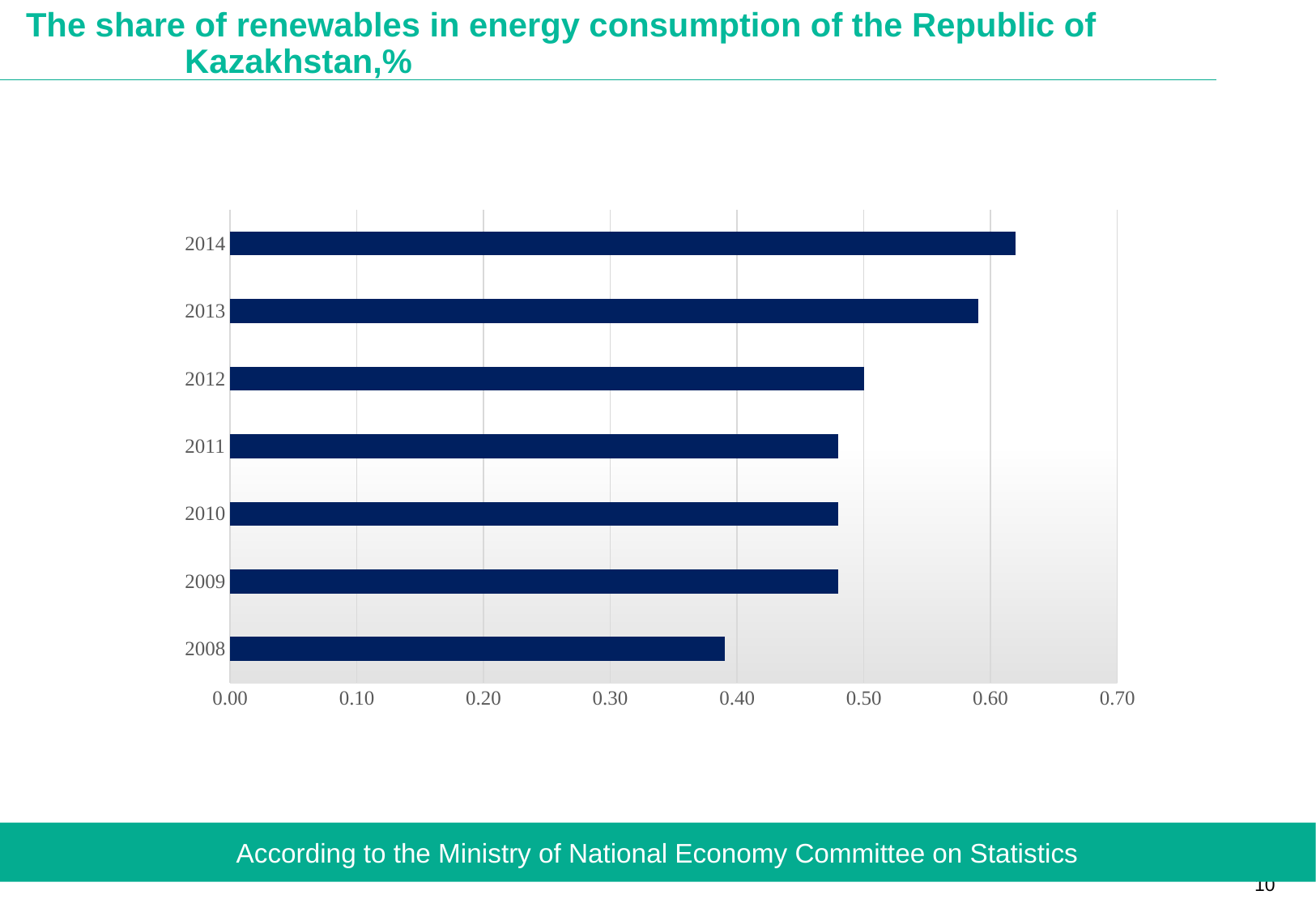
Do the values generally rise or fall from 2008 to 2014? rise Is the value for 2014 greater or less than 0.60? greater Which year has the lowest share of renewables? 2008 Which year has a larger value, 2008 or 2012? 2012 Is the value for 2013 greater or less than 0.60? less Which year has a larger value, 2014 or 2013? 2014 Is the value for 2009 greater or less than 0.40? greater How many years are shown on the chart? 7 Which year has the highest share of renewables? 2014 What kind of chart is shown on the slide? bar chart